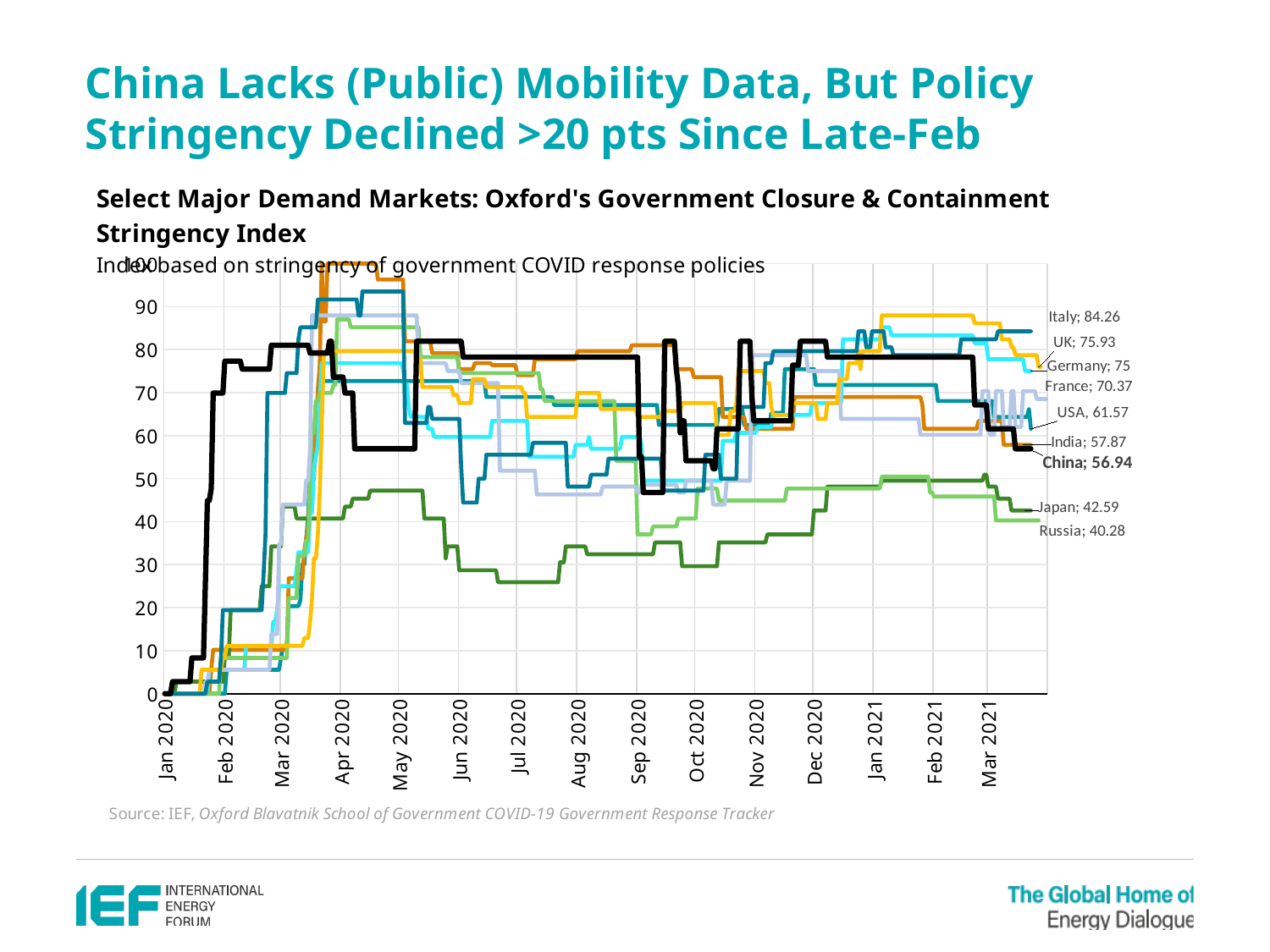
What is the latest value shown for Italy on the stringency index chart? 84.26 What is the latest value shown for China on the chart? 56.94 What is the latest value shown for Russia on the chart? 40.28 How many countries are plotted on the chart? 9 Which country has the highest latest value on the chart? Italy What is the latest value shown for France on the chart? 70.37 What kind of chart is shown on the slide? Line chart Which country has the lowest latest value on the chart? Russia What is the difference between the latest values for Italy and Russia? 43.98 Does China's line rise or fall between Feb 2021 and Mar 2021? Fall Which has a higher latest value, the USA or India? USA What is the difference between the latest values for Japan and Russia? 2.31